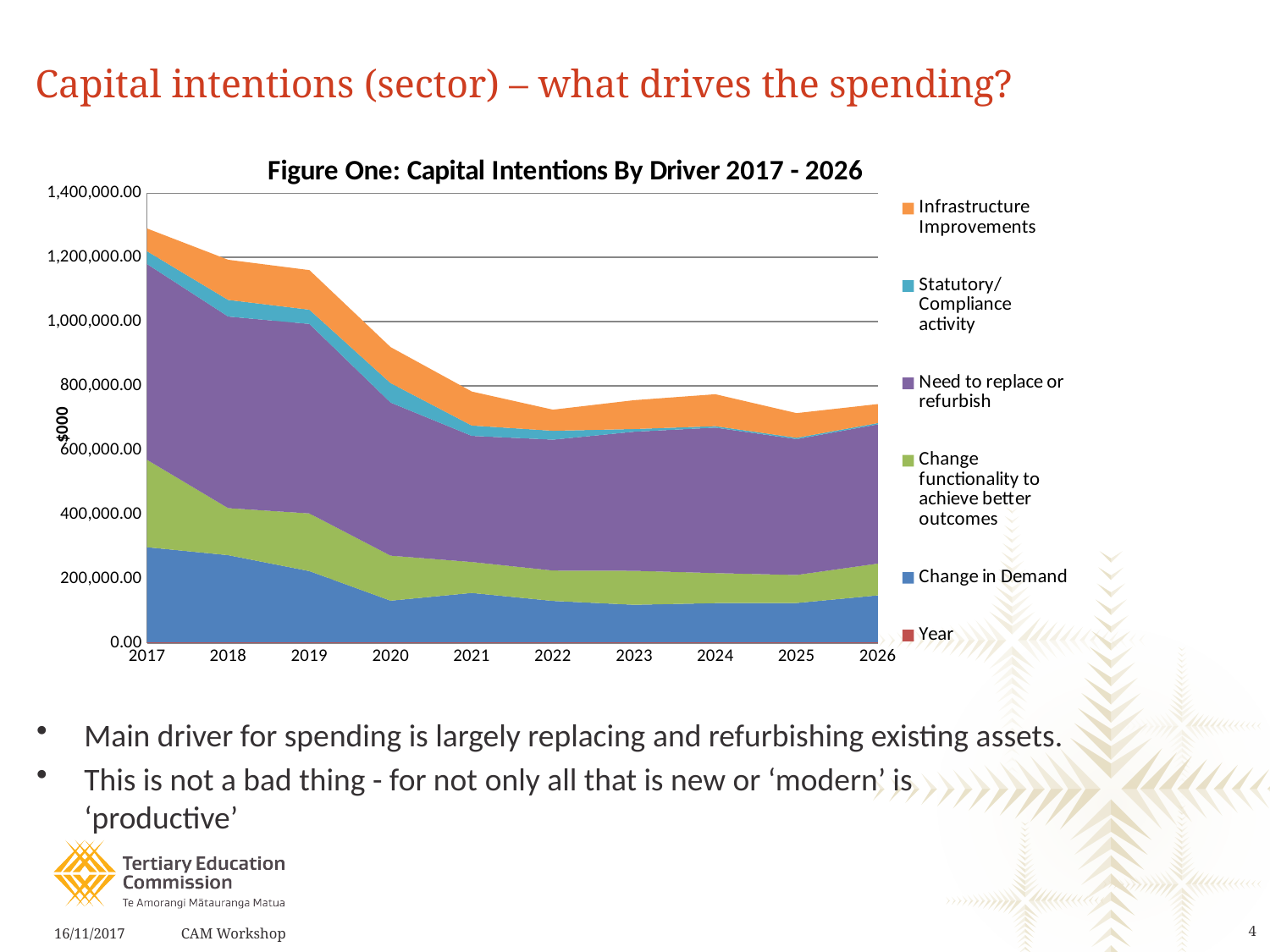
Which driver accounts for the largest share of capital intentions across the years in Figure One? Need to replace or refurbish What is the title of the chart on the slide? Figure One: Capital Intentions By Driver 2017 - 2026 Is the value for Change in Demand in 2017 greater or less than 200,000.00? greater How many years are plotted along the x axis of Figure One? 10 How many entries does the legend of Figure One list? 6 Is the total capital intention for 2026 greater or less than 800,000.00? less Is the total capital intention for 2017 greater or less than 1,200,000.00? greater What is the label on the vertical axis of Figure One? $000 Does the total capital intention in Figure One rise or fall between 2017 and 2021? Fall Which year has the highest total capital intention in Figure One? 2017 What kind of chart is shown in Figure One? Stacked area chart